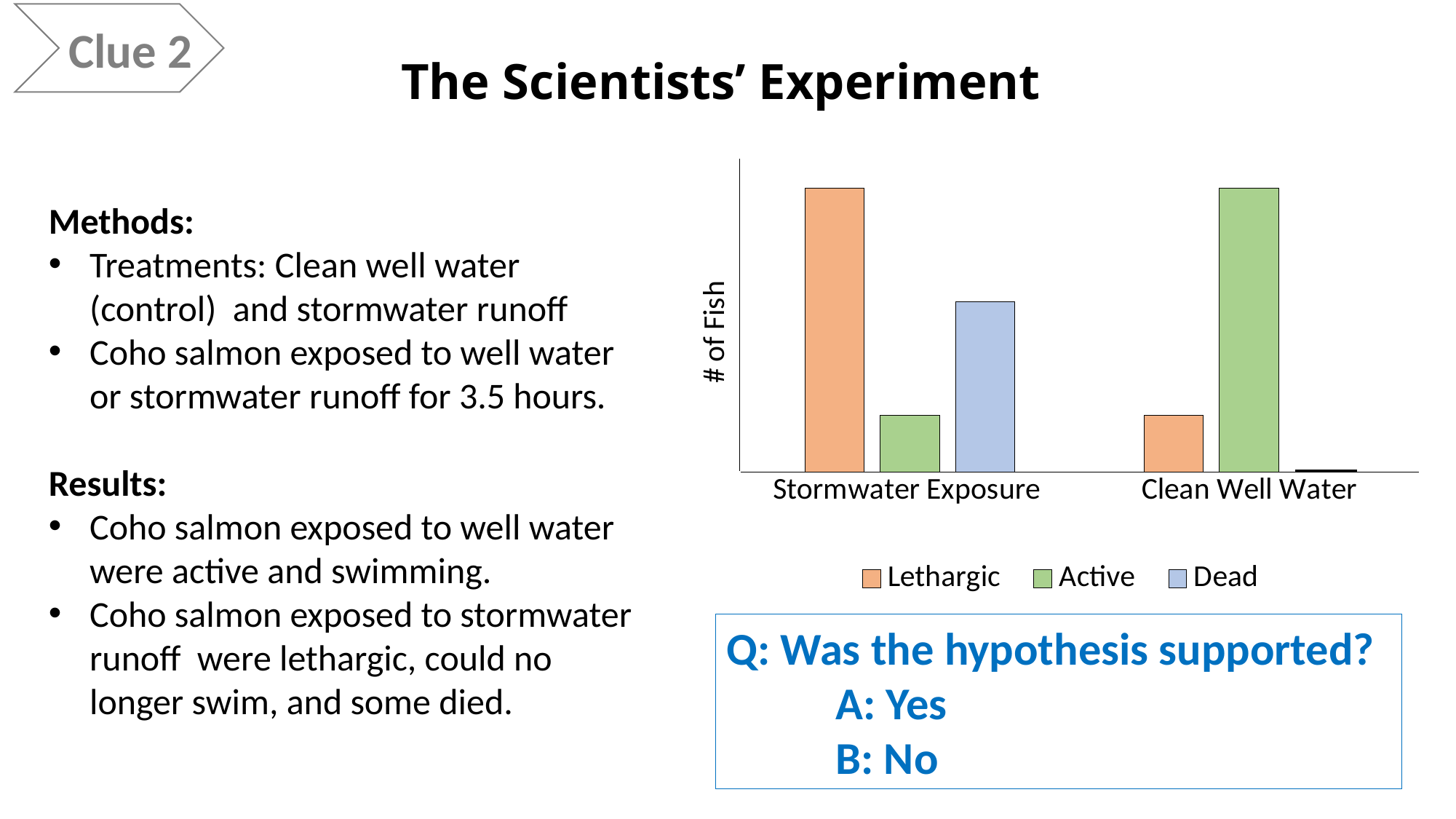
Which colour represents the Dead series in the chart legend? blue What is the label on the vertical axis of the chart? # of Fish How many categories are shown on the x axis of the chart? 2 What kind of chart is shown on the slide? bar chart Which series has the highest value for Clean Well Water? Active Is the Active value larger for Stormwater Exposure or for Clean Well Water? Clean Well Water For Stormwater Exposure, is the Dead value larger or smaller than the Active value? larger Which series has the lowest value for Clean Well Water? Dead Which series has the lowest value for Stormwater Exposure? Active Which series has the highest value for Stormwater Exposure? Lethargic How many series does the chart legend list? 3 Is the Lethargic value larger for Stormwater Exposure or for Clean Well Water? Stormwater Exposure